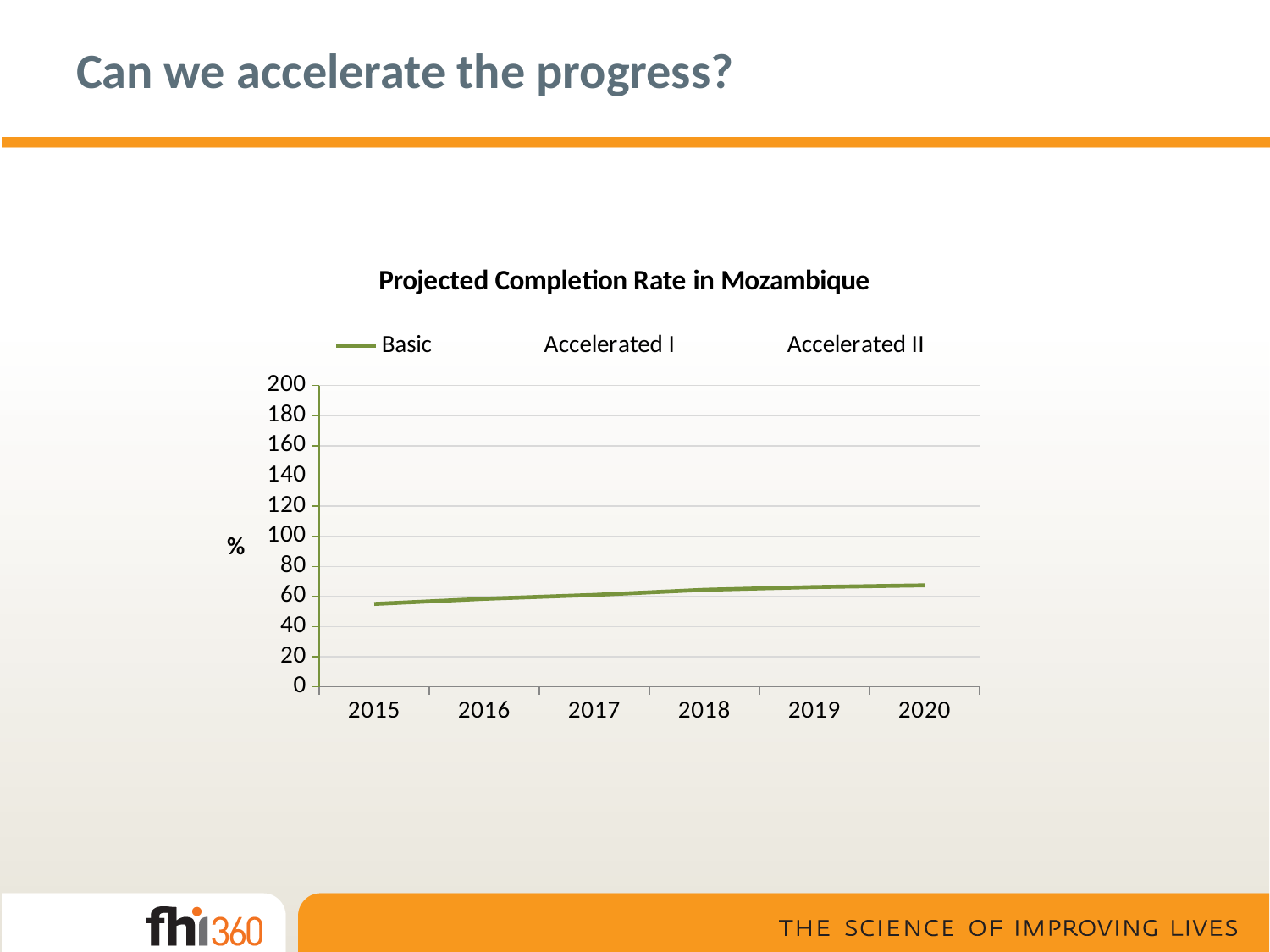
Is the Basic value for 2018 greater or less than 100? less How many series does the legend list? 3 What is the title of the chart? Projected Completion Rate in Mozambique What label is shown on the vertical axis? % Does the Basic line rise or fall from 2015 to 2020? rises Which is larger for the Basic series, the value in 2015 or the value in 2020? 2020 Is the Basic value for 2015 greater or less than 60? less Is the Basic value for 2020 greater or less than 60? greater In which year is the Basic line at its highest? 2020 How many years are shown along the x axis? 6 In which year is the Basic line at its lowest? 2015 What kind of chart is shown on the slide? line chart